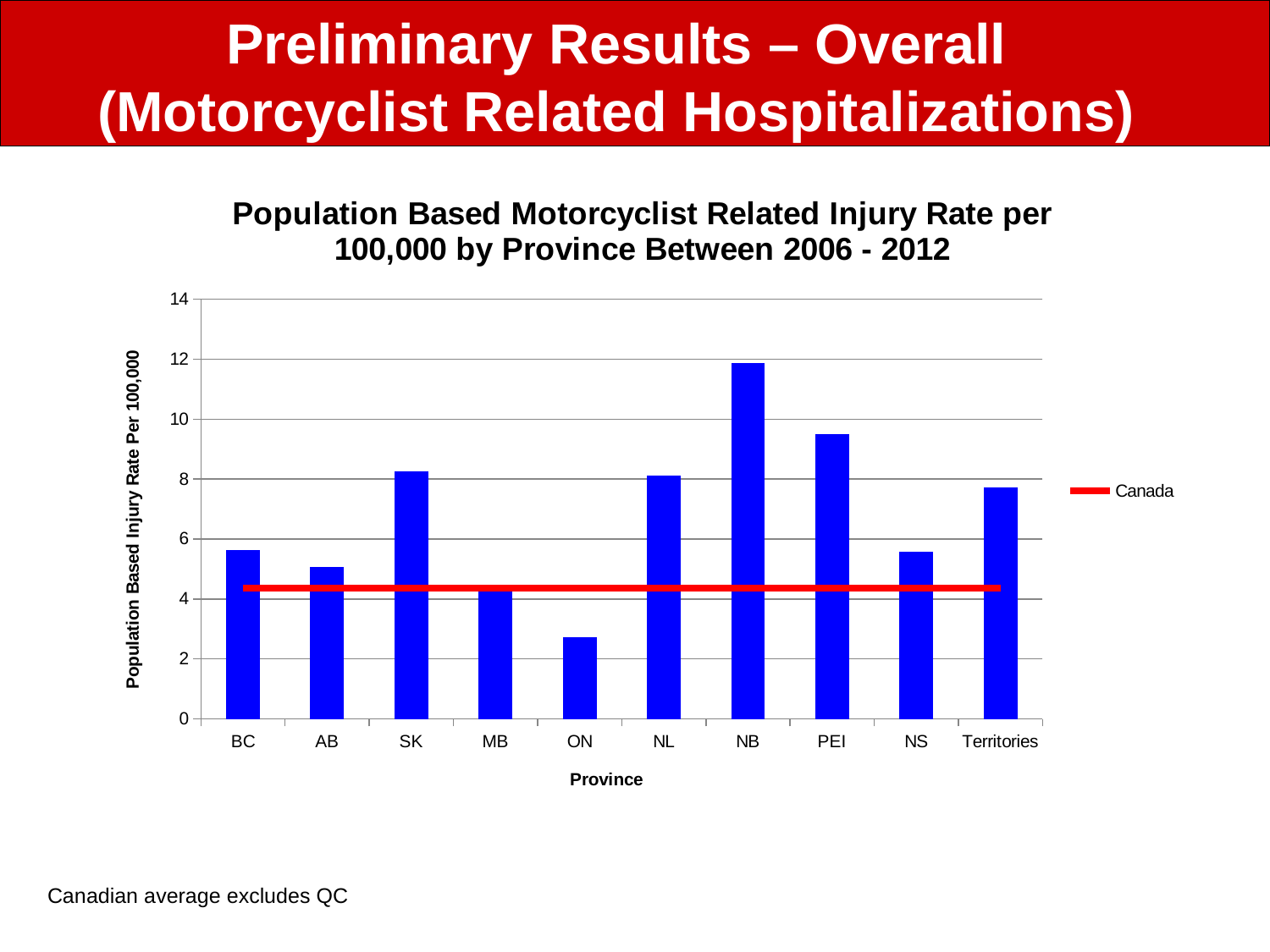
What is the label of the x axis? Province Which province has the lowest population based motorcyclist related injury rate? ON Is the value for MB greater or less than 6? less Is the value for PEI greater or less than 8? greater What kind of chart is shown on the slide? bar chart Which has a higher injury rate, PEI or NL? PEI Which has a higher injury rate, SK or AB? SK Is the value for NB greater or less than 10? greater How many provinces/regions are shown on the x axis? 10 What does the red horizontal line in the chart represent, according to the legend? Canada Which province has the highest population based motorcyclist related injury rate? NB